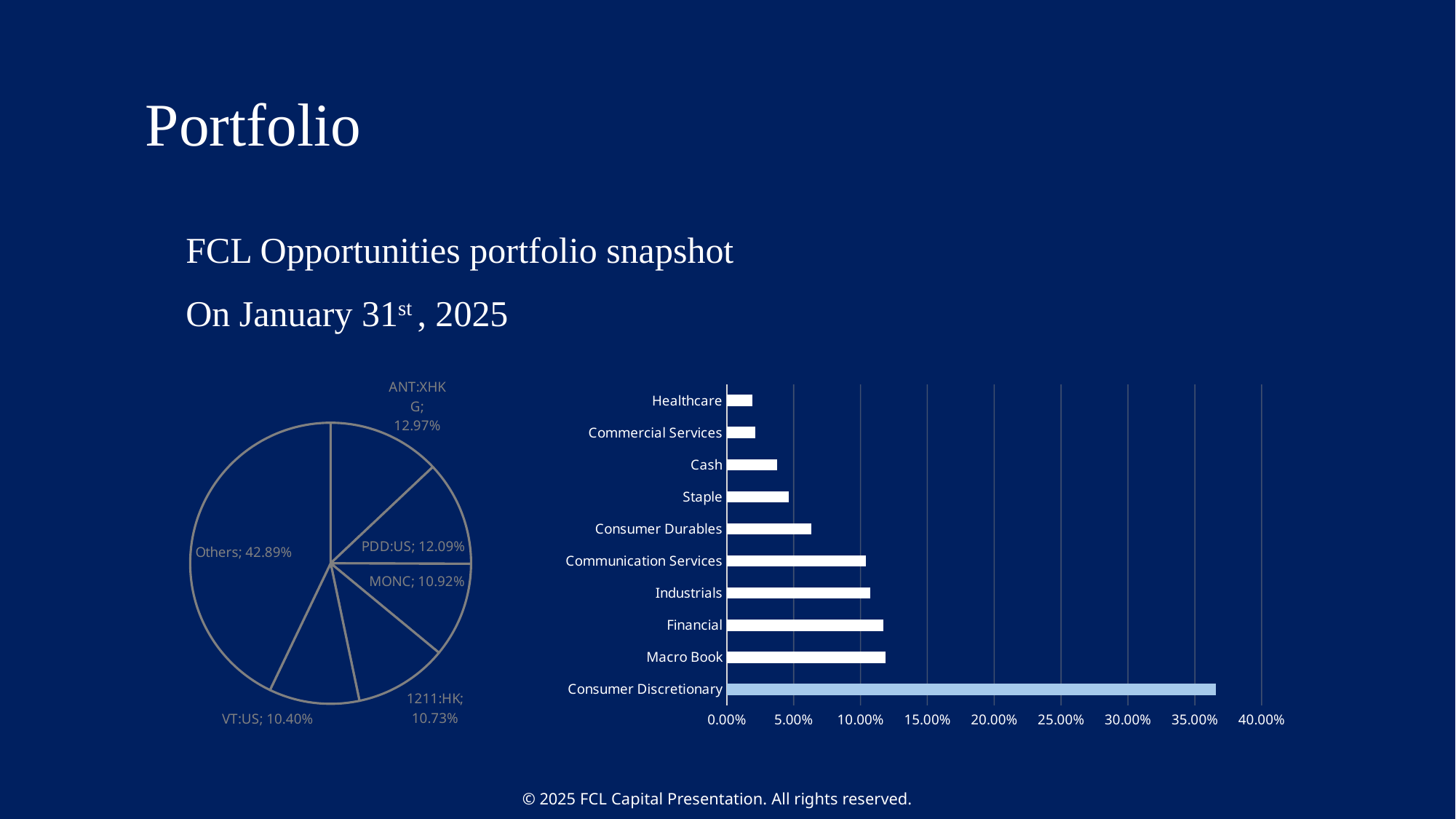
How many categories are shown in the bar chart on the right? 10 In the bar chart on the right, which category has the highest value? Consumer Discretionary In the pie chart on the left, which slice is the largest? Others How many slices does the pie chart on the left have? 6 In the pie chart on the left, which is larger: MONC or 1211:HK? MONC In the bar chart on the right, is the value for Consumer Durables greater or less than 10.00%? less In the bar chart on the right, is the value for Consumer Discretionary greater or less than 35.00%? greater In the pie chart on the left, which slice is the smallest? VT:US What kind of chart is the chart on the right of the slide? bar chart In the pie chart on the left, what is the value shown for MONC? 10.92% In the pie chart on the left, what is the difference between the ANT:XHKG share and the PDD:US share? 0.88% In the pie chart on the left, what share does Others hold? 42.89%